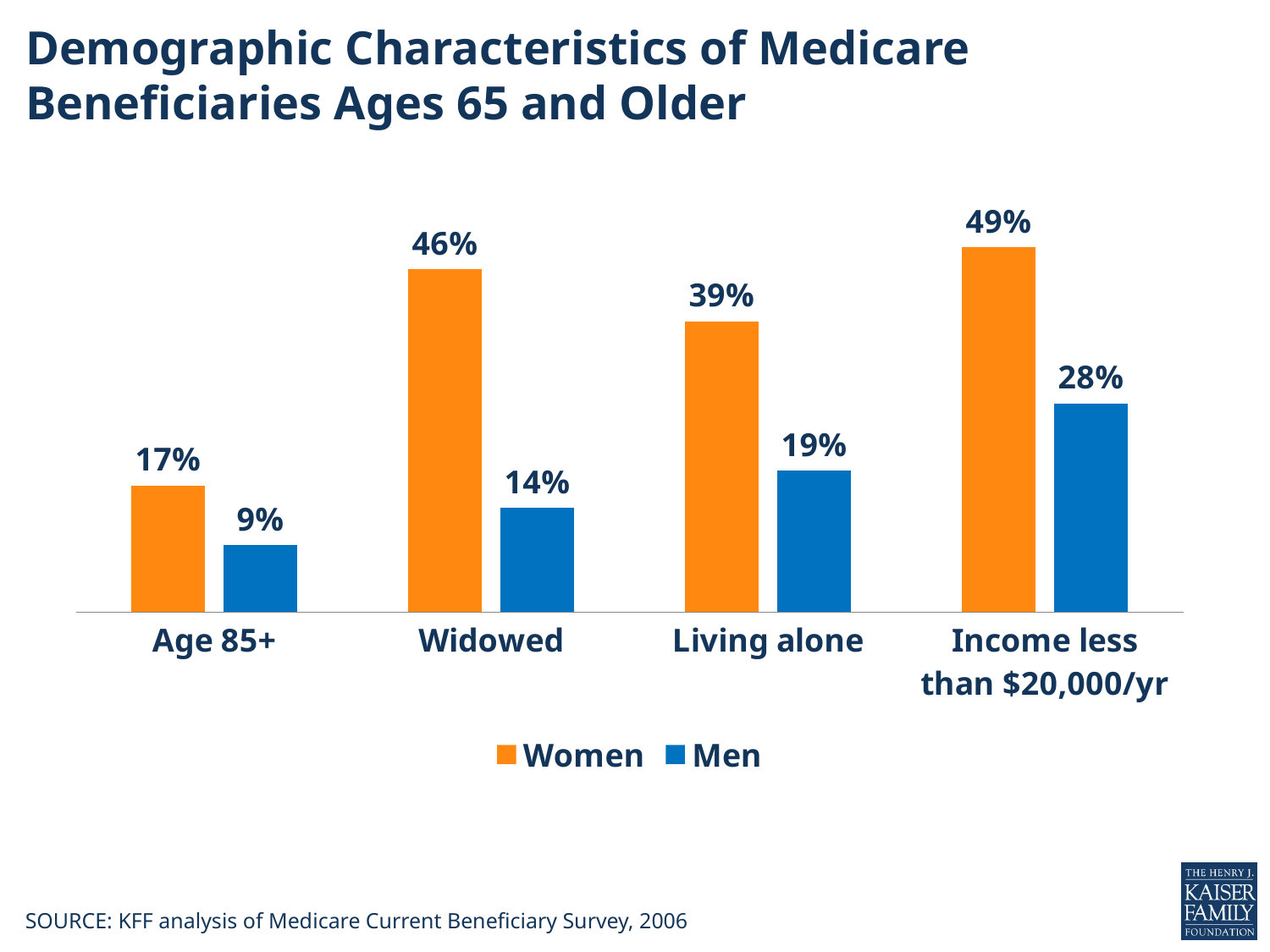
Which is larger: the value for men with income less than $20,000/yr or the value for women in the Age 85+ category? Men with income less than $20,000/yr Which category has the highest value for women? Income less than $20,000/yr What kind of chart is shown on the slide? Bar chart What percentage of women Medicare beneficiaries ages 65 and older are widowed? 46% Which category has the lowest value for men? Age 85+ How many categories are shown on the x axis? 4 What percentage of men have income less than $20,000/yr? 28% How many series does the legend list? 2 What is the value for women in the Living alone category? 39% What is the difference between the women and men values for Living alone? 20 percentage points What is the value for men in the Age 85+ category? 9% What is the difference between the women and men values in the Widowed category? 32 percentage points